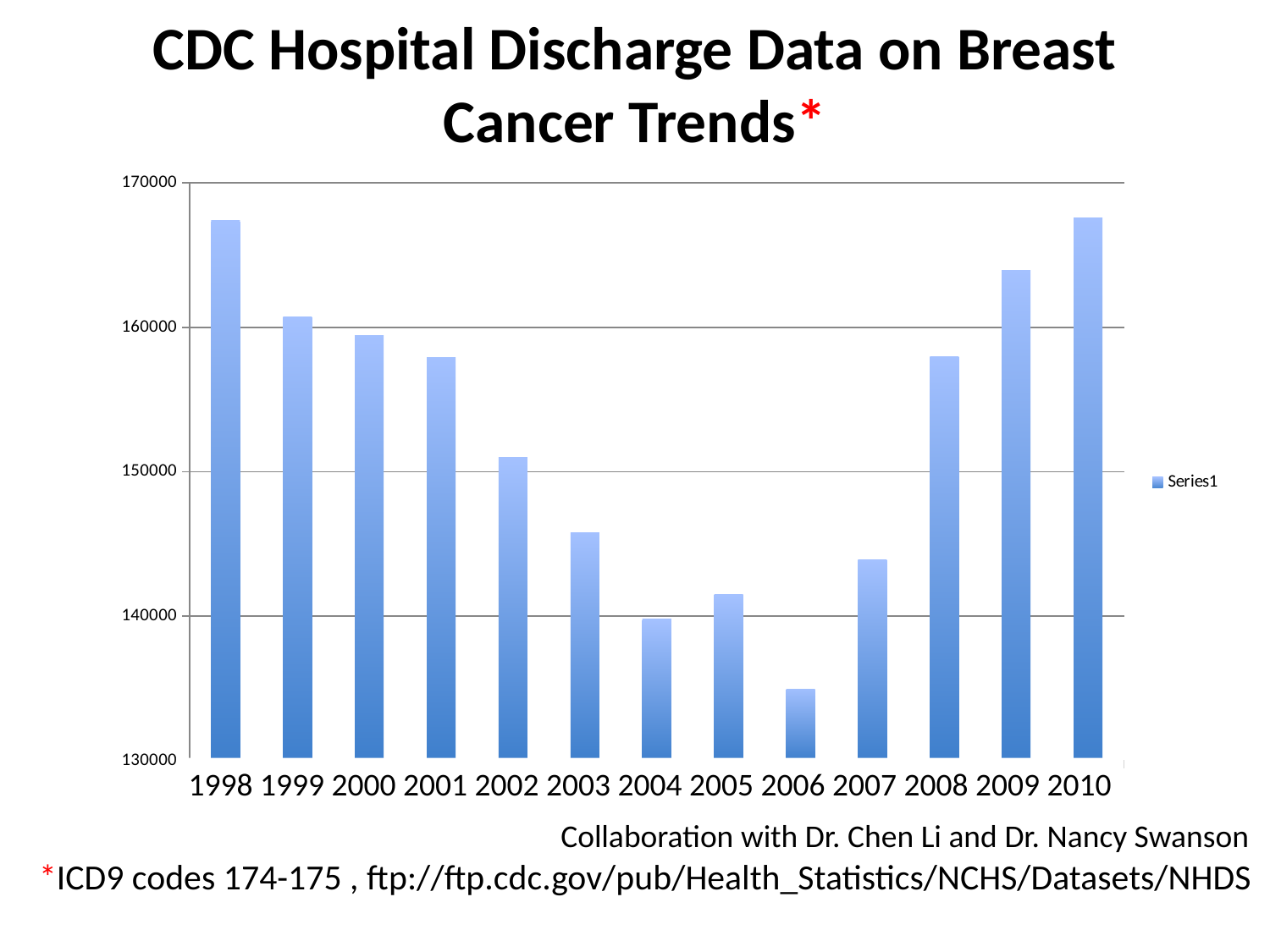
Is the value for 2006 greater or less than 140000? less Which is larger, the value for 2008 or the value for 2009? 2009 Is the value for 2009 greater or less than 160000? greater How many years are shown on the x axis of the chart? 13 Is the value for 2007 greater or less than 150000? less Which year has the lowest value in the chart? 2006 How many series does the legend list? 1 What kind of chart is shown on the slide? bar chart What is the legend entry shown on the chart? Series1 Do the values rise or fall from 1998 to 2006? fall